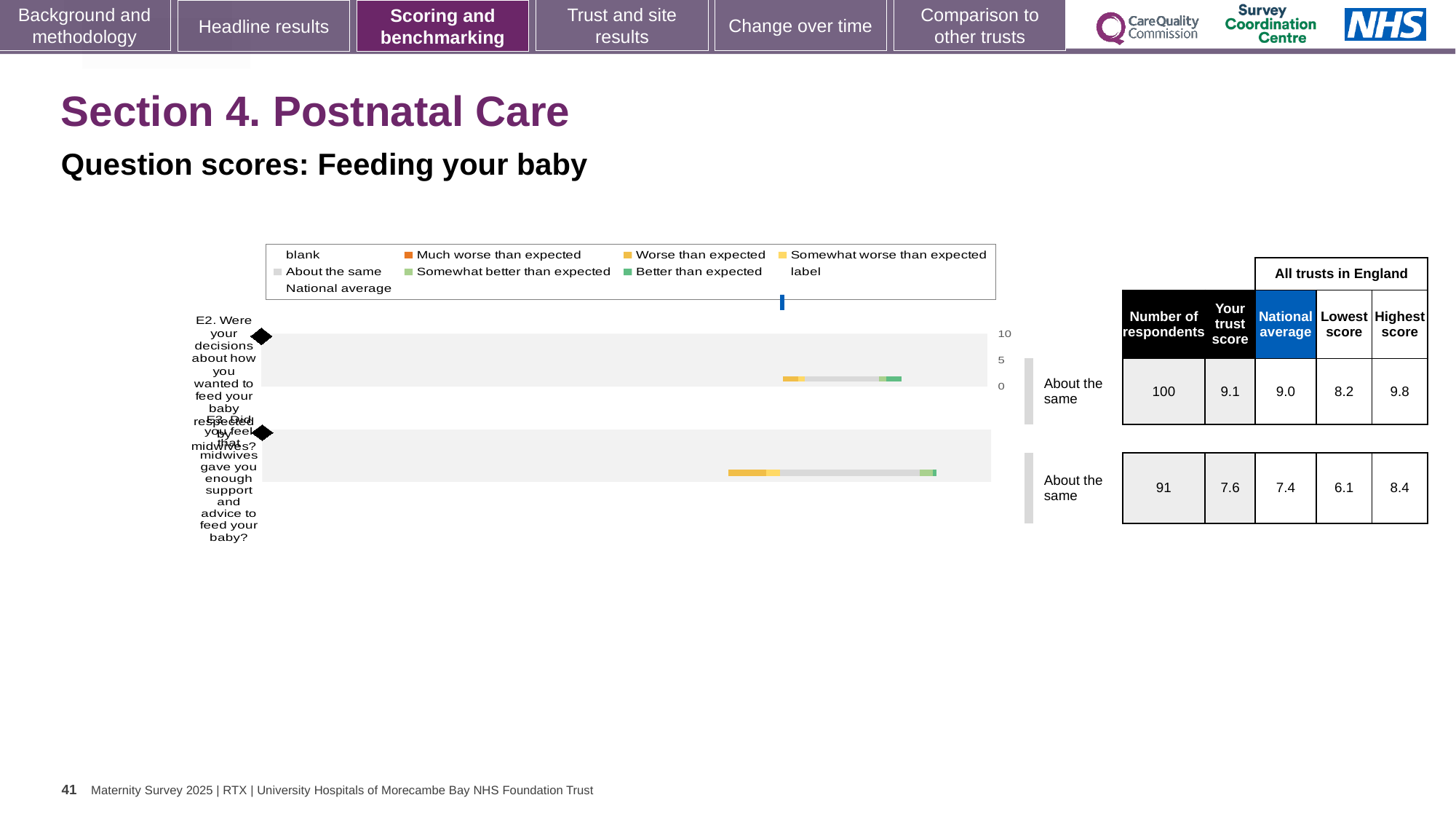
What is the difference between the trust score and the national average for question E3 about support and advice to feed your baby? 0.2 How many questions (categories) are plotted in the Feeding your baby chart? 2 What is the trust score for question E3 about midwives giving enough support and advice to feed your baby? 7.6 What is the highest score among all trusts in England for question E2 about feeding decisions being respected? 9.8 What kind of chart is used to show the question scores for Feeding your baby? bar chart How many respondents answered question E3 about support and advice to feed your baby? 91 What is the national average for question E2 about decisions on feeding your baby being respected by midwives? 9.0 What benchmark category is shown for question E2 about feeding decisions being respected by midwives? About the same What is the lowest score among all trusts in England for question E3 about support and advice to feed your baby? 6.1 What is the trust score for question E2 about decisions on how you wanted to feed your baby being respected by midwives? 9.1 Which question has the higher trust score, E2 (feeding decisions respected) or E3 (support and advice to feed your baby)? E2 What is the national average for question E3 about midwives giving enough support and advice to feed your baby? 7.4